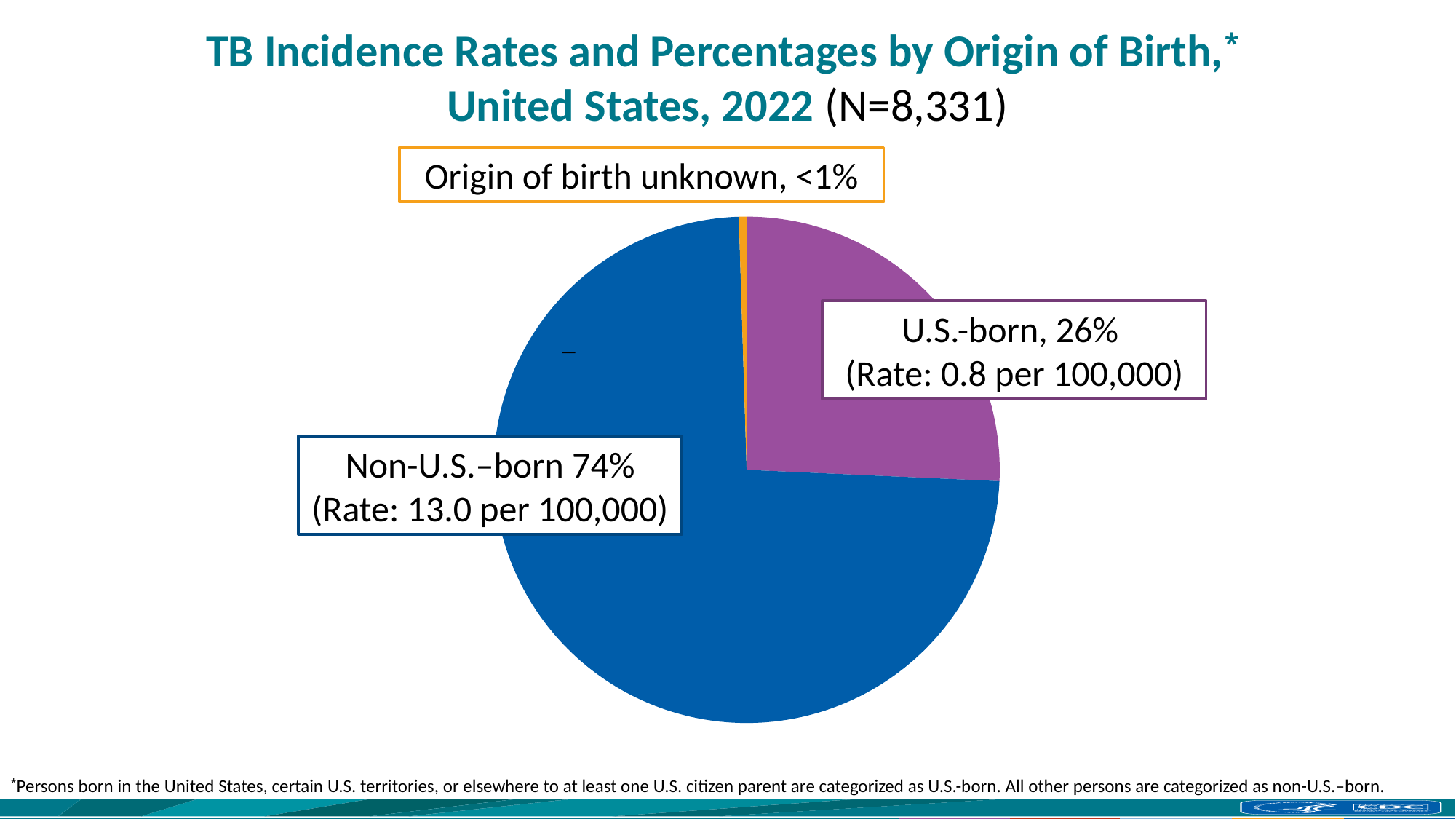
What percentage of TB cases is attributed to non-U.S.-born persons? 74% What kind of chart is shown on the slide? pie chart What is the total number of cases (N) given in the chart title? 8,331 What percentage of TB cases is attributed to U.S.-born persons? 26% What percentage of cases have an unknown origin of birth? <1% What is the difference in percentage points between the non-U.S.-born and U.S.-born shares? 48 Which origin-of-birth category has the smallest share of the pie? Origin of birth unknown What is the TB incidence rate for U.S.-born persons? 0.8 per 100,000 Which origin-of-birth category has the largest share of the pie? Non-U.S.-born What is the TB incidence rate for non-U.S.-born persons? 13.0 per 100,000 Which is larger, the share for U.S.-born or the share for non-U.S.-born? Non-U.S.-born How many slices does the pie chart have? 3